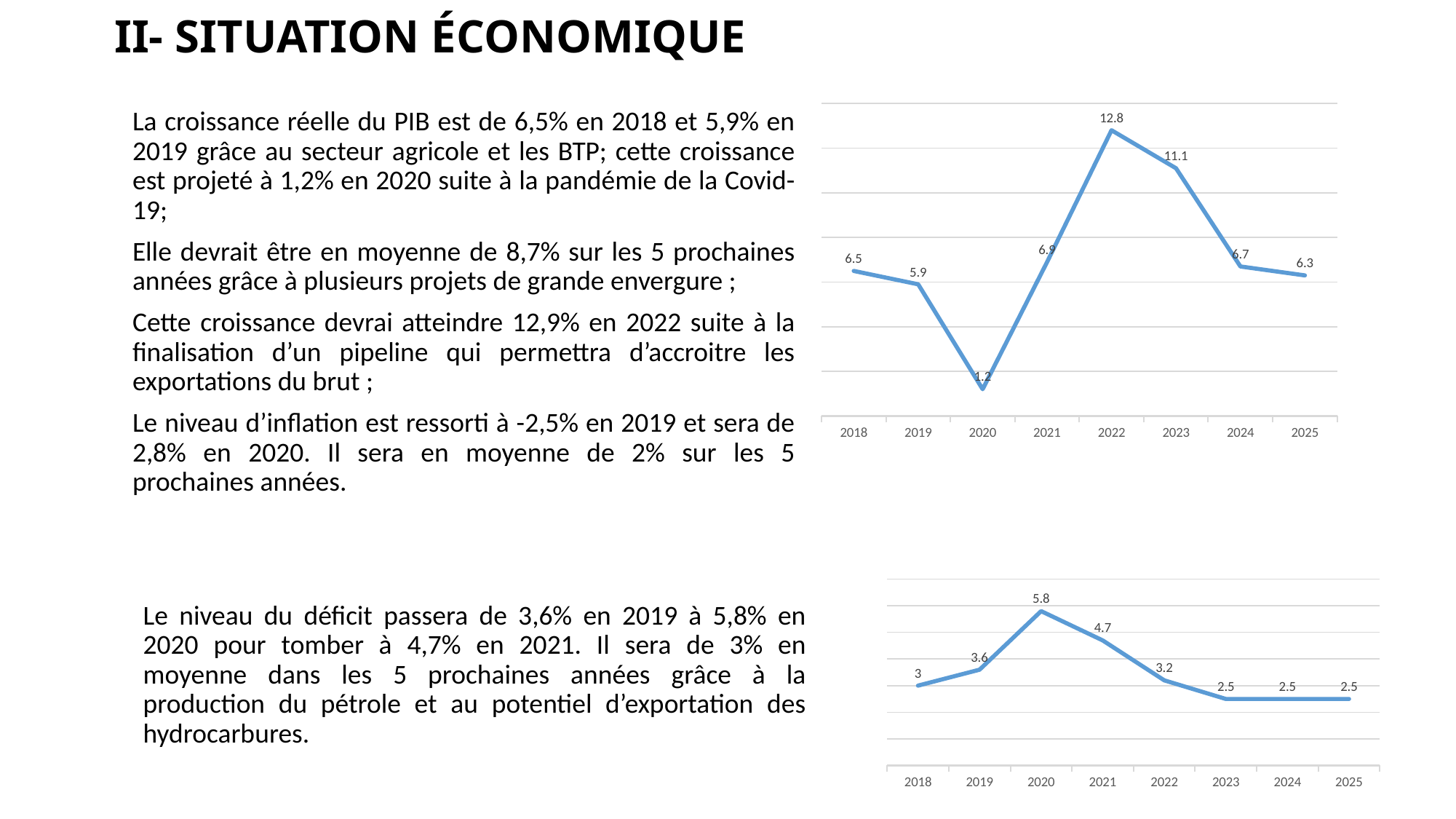
How many data points are plotted in the top chart on the right? 8 In the top chart on the right, which is larger, the value for 2018 or the value for 2024? 2024 In the top chart on the right, what is the value for 2020? 1.2 In the top chart on the right, what is the difference between the values for 2022 and 2023? 1.7 What kind of chart is the bottom chart on the right? Line chart In the bottom chart on the right, do the values rise or fall from 2020 to 2023? Fall In the bottom chart on the right, which year has the highest value? 2020 In the top chart on the right, what is the value for 2022? 12.8 In the top chart on the right, which year has the highest value? 2022 In the top chart on the right, which year has the lowest value? 2020 In the bottom chart on the right, what is the value for 2020? 5.8 In the bottom chart on the right, what is the difference between the values for 2020 and 2021? 1.1